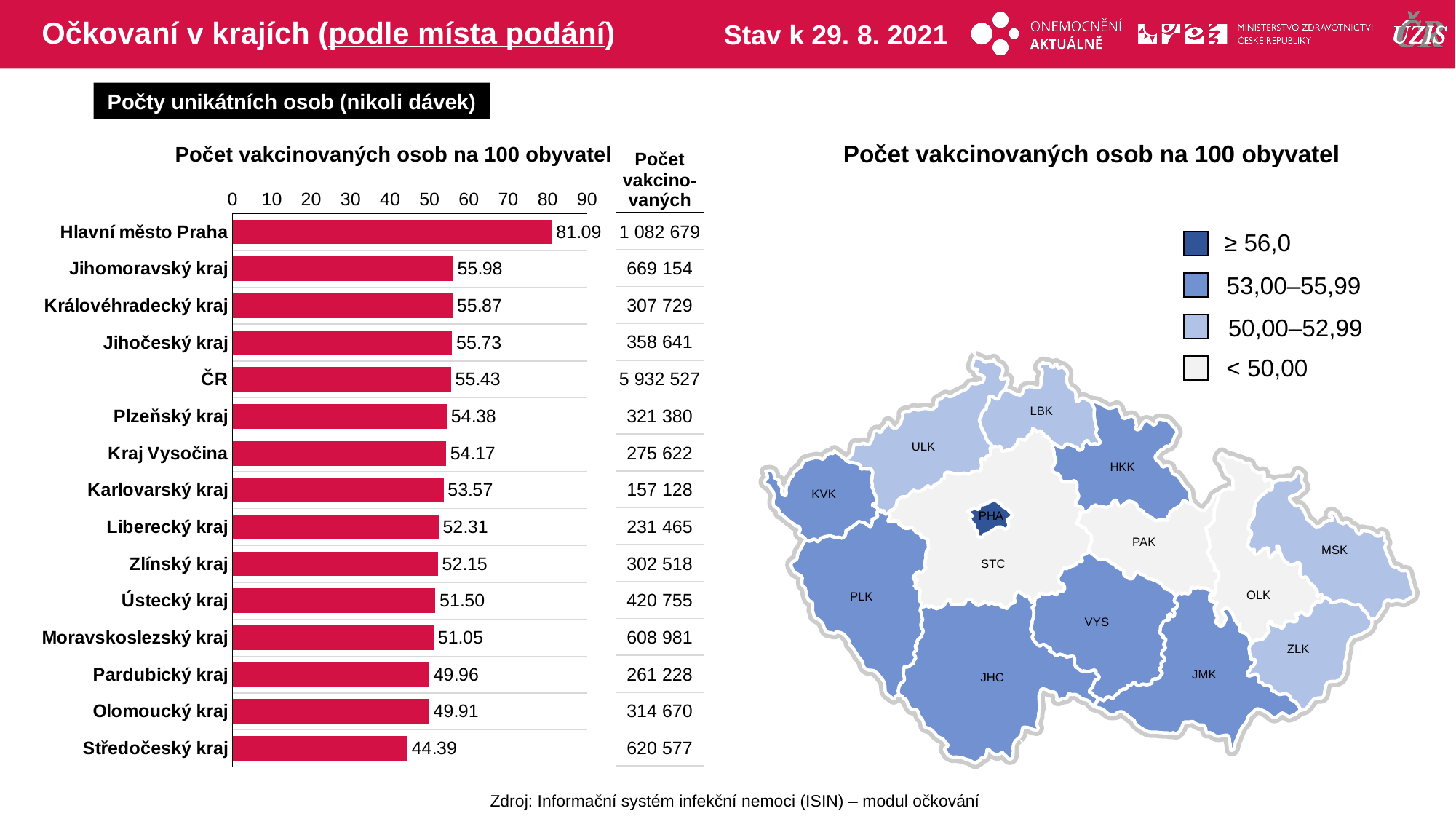
In the bar chart, which region has the highest number of vaccinated persons per 100 inhabitants? Hlavní město Praha In the bar chart, what is the value for Kraj Vysočina? 54.17 In the bar chart, what is the value for ČR? 55.43 In the bar chart, what is the difference between the values for Hlavní město Praha and Středočeský kraj? 36.70 How many bars (categories) are shown in the bar chart? 15 In the bar chart, is the value for Hlavní město Praha greater or less than 80? greater In the bar chart, what is the value for Hlavní město Praha? 81.09 In the bar chart, which has a larger value: Plzeňský kraj or Liberecký kraj? Plzeňský kraj How many colour classes does the legend of the map on the right list? 4 What kind of chart is the 'Počet vakcinovaných osob na 100 obyvatel' chart on the left of the slide? bar chart In the bar chart, which region has the lowest number of vaccinated persons per 100 inhabitants? Středočeský kraj In the bar chart, is the value for Středočeský kraj greater or less than 50? less